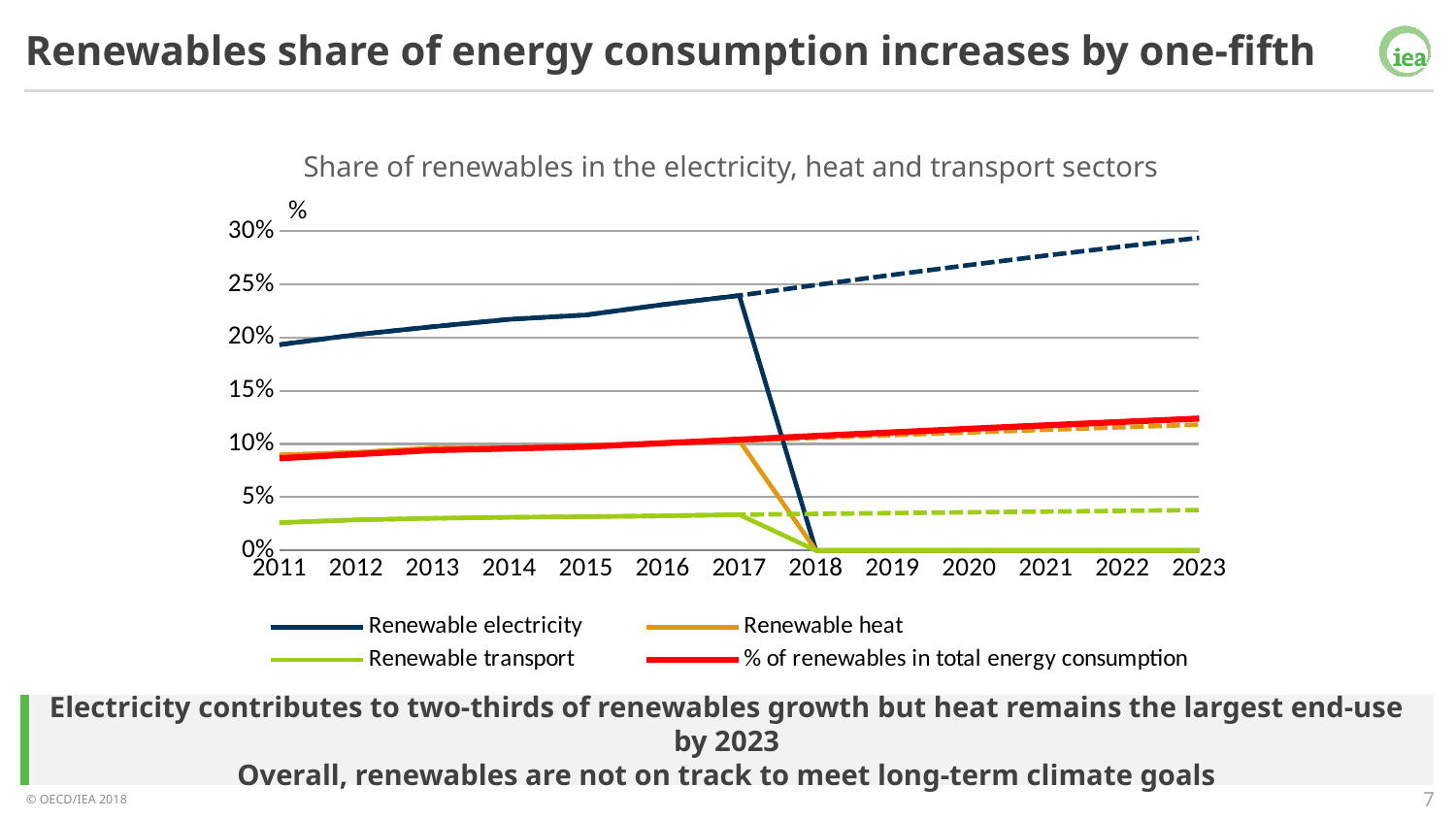
Does the Renewable electricity series rise or fall from 2011 to 2017? rise Is the value for % of renewables in total energy consumption in 2023 greater or less than 10%? greater Which series has the lowest value in 2011? Renewable transport Which is larger in 2017, Renewable electricity or Renewable transport? Renewable electricity How many years are shown on the x axis of the chart? 13 Is the value for Renewable electricity in 2017 greater or less than 25%? less What kind of chart is shown on the slide? line chart What is the title of the chart? Share of renewables in the electricity, heat and transport sectors How many series does the chart legend list? 4 Which series has the highest value in 2011? Renewable electricity Is the value for Renewable transport in 2011 greater or less than 5%? less